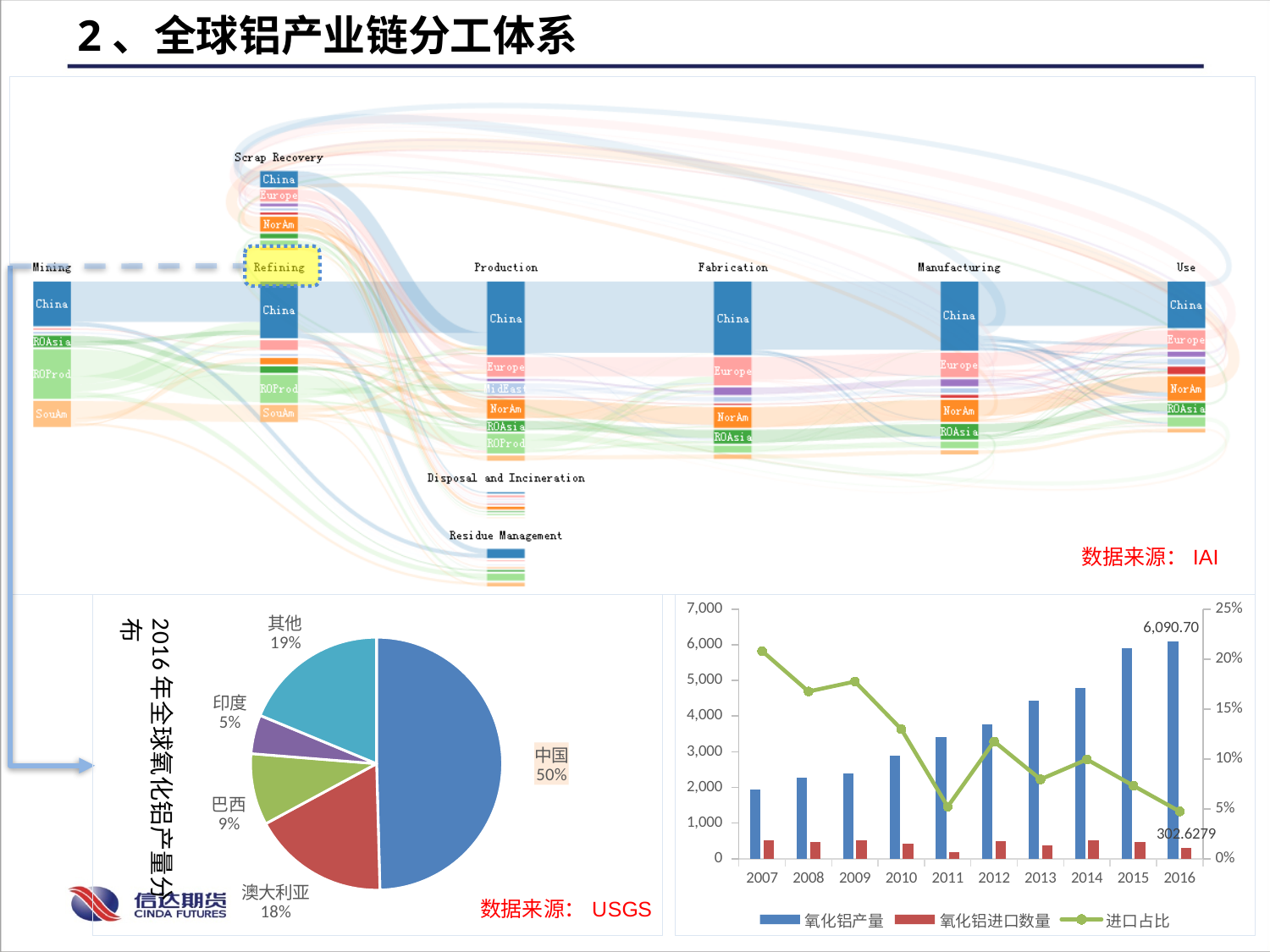
In the bottom-right chart, what is the data label shown for 氧化铝进口数量 in 2016? 302.6279 In the pie chart titled 2016年全球氧化铝产量分布, how many slices are there? 5 In the bottom-right chart, does the 进口占比 line generally rise or fall from 2007 to 2016? fall In the pie chart titled 2016年全球氧化铝产量分布, which is larger, the share of 巴西 or the share of 印度? 巴西 In the pie chart titled 2016年全球氧化铝产量分布, what share does 澳大利亚 hold? 18% In the pie chart titled 2016年全球氧化铝产量分布, what share does 中国 hold? 50% In the pie chart titled 2016年全球氧化铝产量分布, which category has the largest share? 中国 In the bottom-right chart, is the 氧化铝产量 value for 2011 greater or less than 3,000? greater In the pie chart titled 2016年全球氧化铝产量分布, what is the difference between the shares of 其他 and 巴西? 10% In the bottom-right chart, what is the data label shown for 氧化铝产量 in 2016? 6,090.70 In the pie chart titled 2016年全球氧化铝产量分布, which category has the smallest share? 印度 In the bottom-right chart, how many series does the legend list? 3